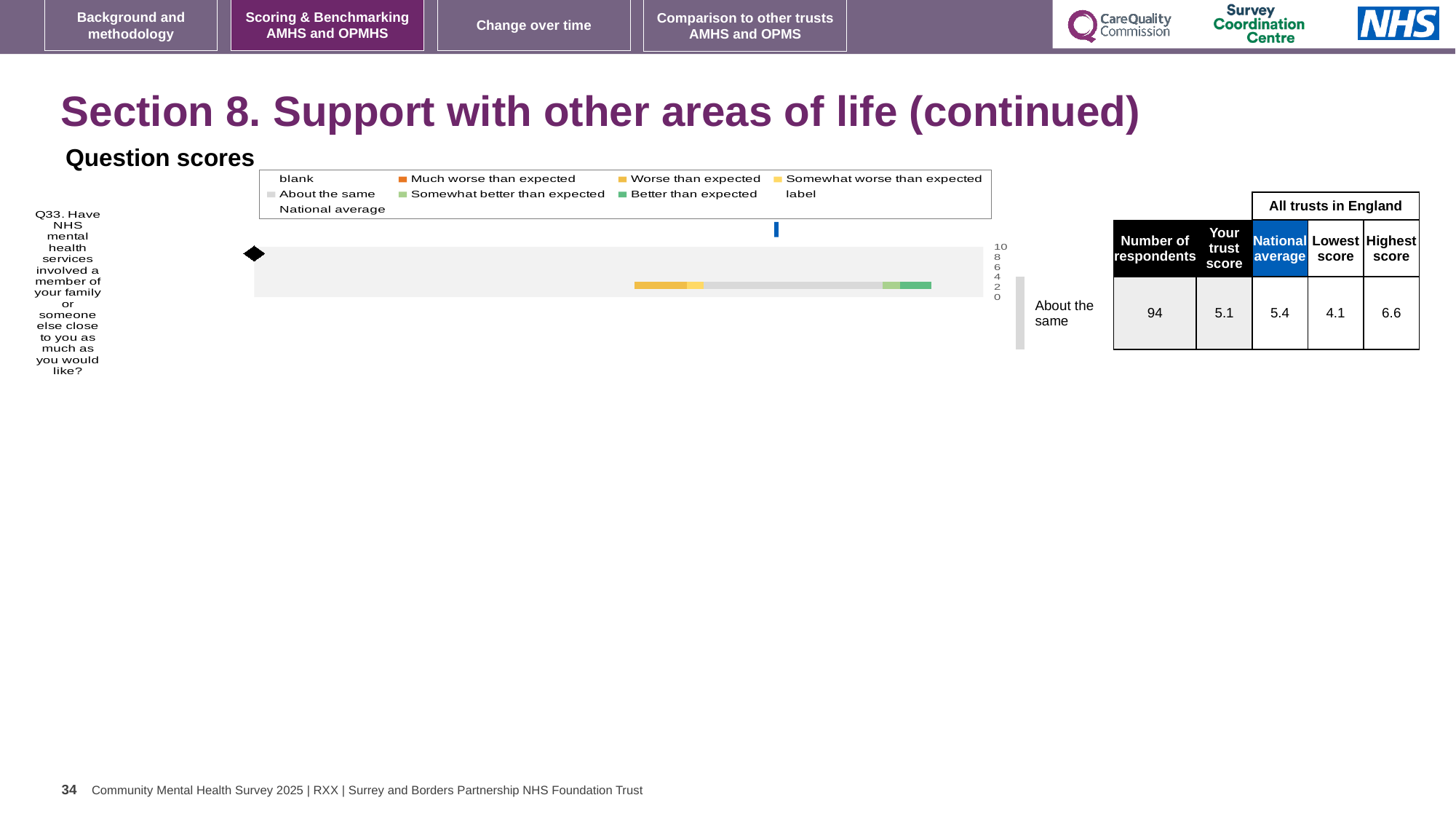
What is the difference between the highest score and the lowest score for Q33? 2.5 How many respondents are listed for Q33 in the table beside the chart? 94 What is the trust score for Q33 shown in the table beside the chart? 5.1 What is the national average for Q33 shown in the table beside the chart? 5.4 What benchmark category is shown for Q33 next to the chart? About the same How many questions are plotted in the Question scores chart? 1 What is the highest score among all trusts in England for Q33? 6.6 Which question number is plotted in the Question scores chart? Q33 Which is larger for Q33, the trust score or the national average? national average How many entries does the legend of the Question scores chart list? 9 What is the highest tick value shown on the axis of the Question scores chart? 10 What kind of chart is shown under "Question scores"? bar chart